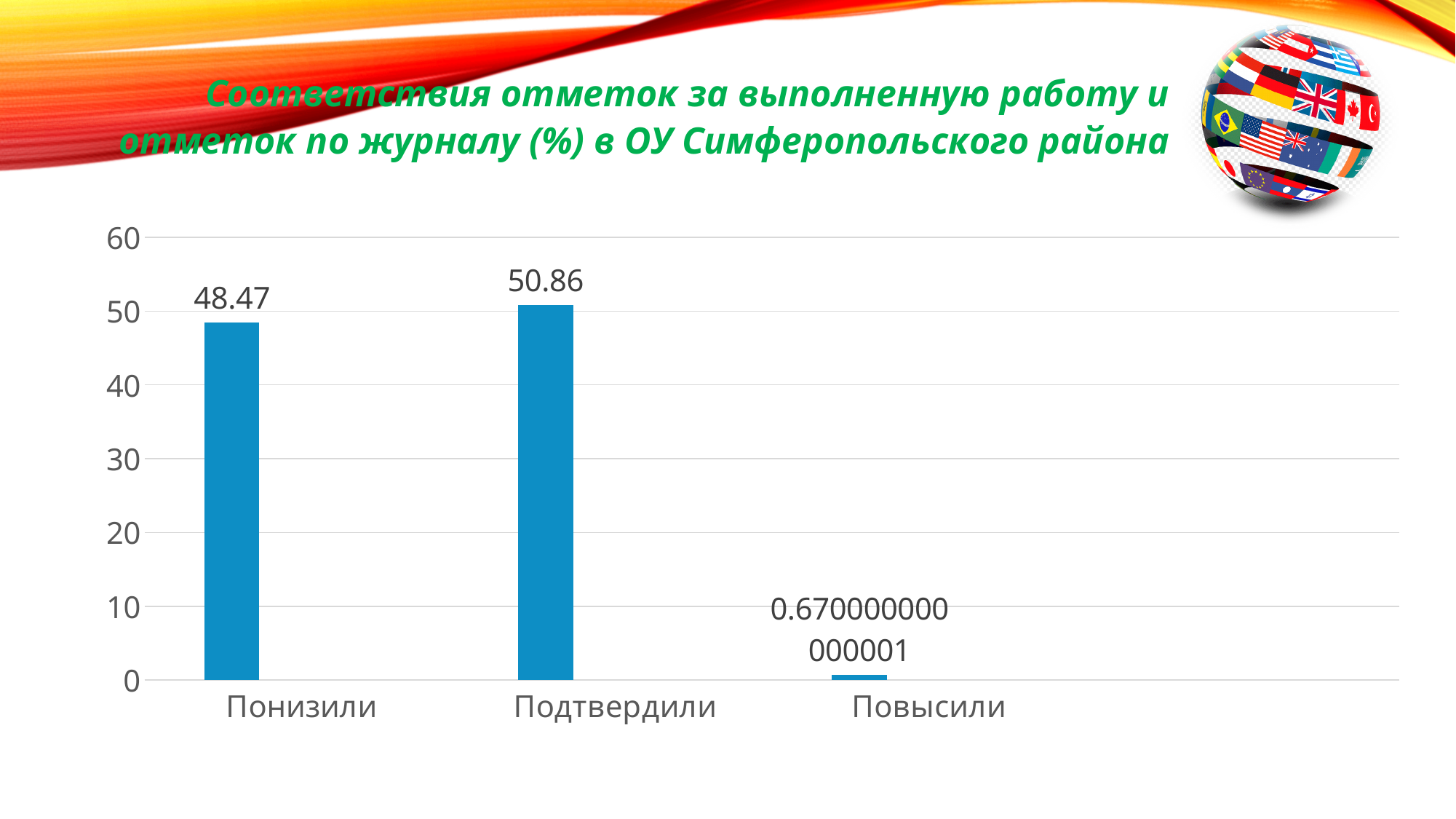
Which is larger, the value for Понизили or the value for Подтвердили? Подтвердили How many categories are shown on the x axis? 3 Is the value for Подтвердили greater or less than 50? greater What colour are the bars in the chart? blue What is the value for Подтвердили? 50.86 Is the value for Понизили greater or less than 50? less What is the value printed above the bar for Повысили? 0.670000000000001 What kind of chart is shown on the slide? bar chart What is the difference between the values for Подтвердили and Понизили? 2.39 What is the value for Понизили? 48.47 Which category has the highest value? Подтвердили Which category has the lowest value? Повысили